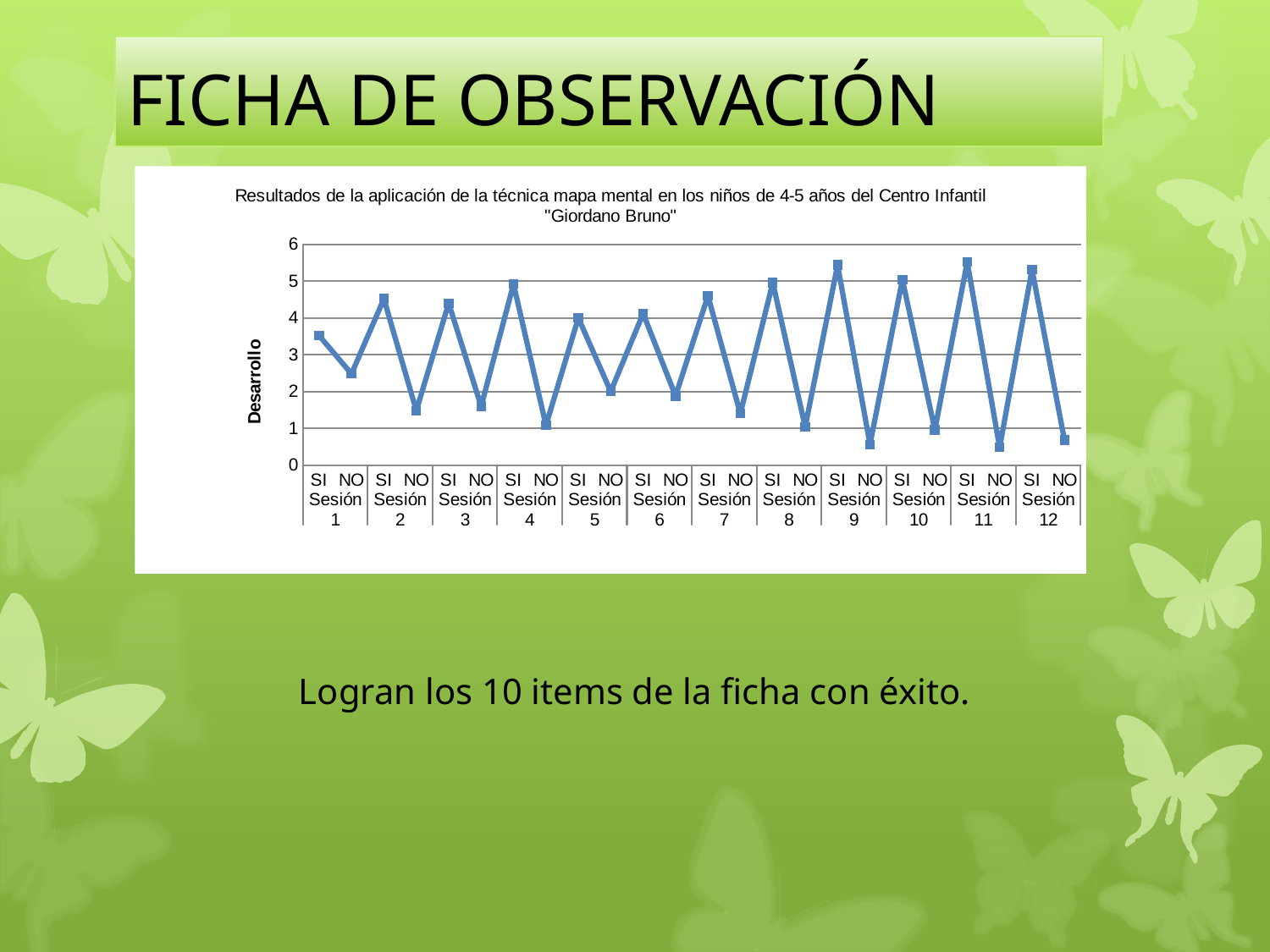
Is the value for NO in Sesión 11 greater or less than 1? less What is the name of the Centro Infantil mentioned in the chart title? "Giordano Bruno" What is the label of the vertical axis of the chart? Desarrollo Is the value for NO in Sesión 2 greater or less than 2? less What kind of chart is shown on the slide? line chart Is the value for SI in Sesión 5 greater or less than 3? greater Which is larger, the value for NO in Sesión 1 or the value for NO in Sesión 9? NO in Sesión 1 How many sessions (Sesión) are shown along the x axis of the chart? 12 How many data points are plotted on the line chart? 24 Which is larger, the value for SI in Sesión 12 or the value for SI in Sesión 1? SI in Sesión 12